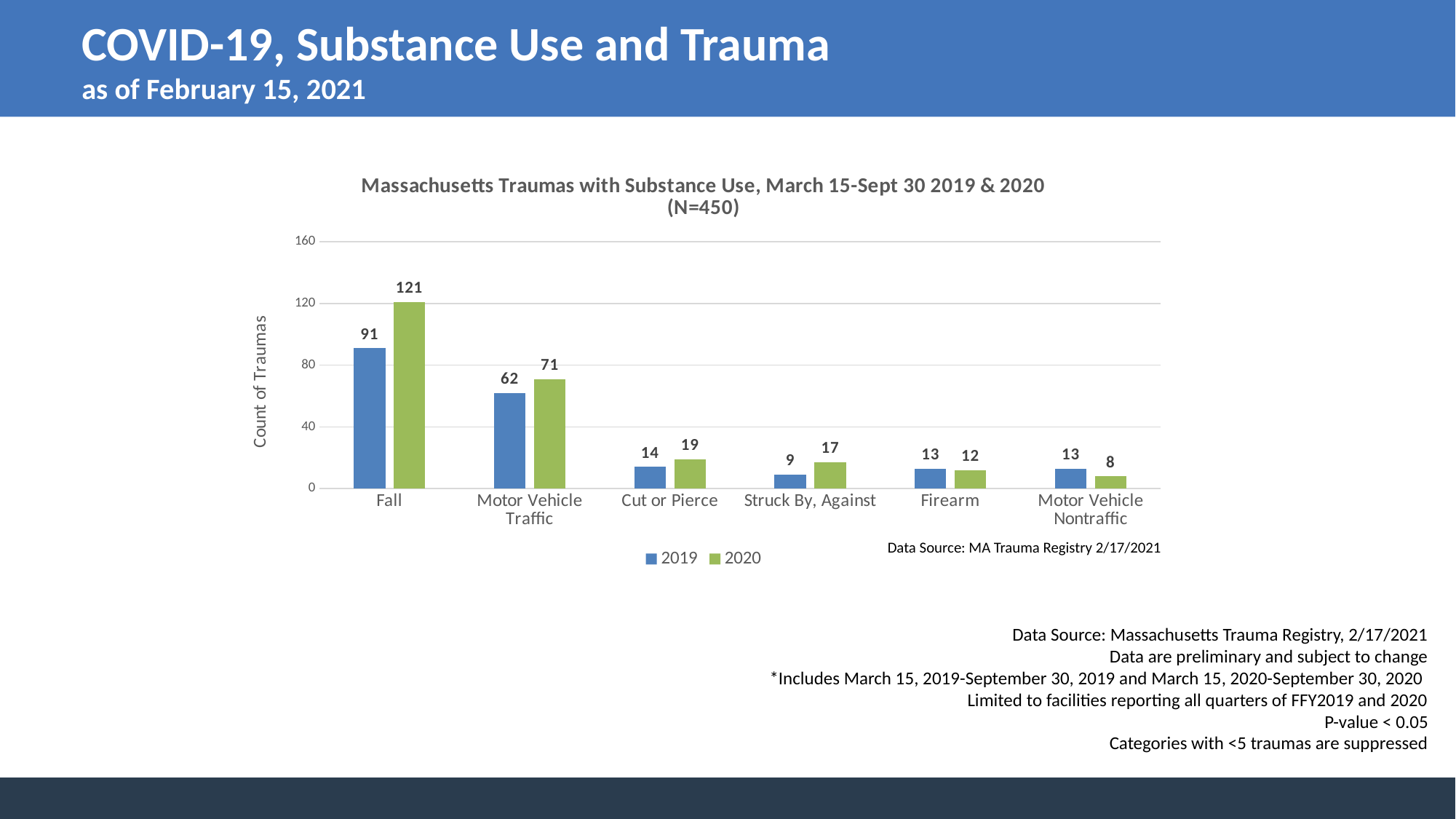
What is the 2020 value for Fall? 121 What is the 2019 value for Motor Vehicle Traffic? 62 What is the 2020 value for Struck By, Against? 17 Which category has the highest 2019 value? Fall What kind of chart is shown? bar chart Is the 2019 value for Fall greater or less than 80? greater How many categories are shown on the x axis? 6 What is the label of the y axis? Count of Traumas What is the difference between the 2020 and 2019 values for Fall? 30 Which category has the lowest 2020 value? Motor Vehicle Nontraffic Which is larger for Firearm, the 2019 value or the 2020 value? 2019 How many series does the legend list? 2